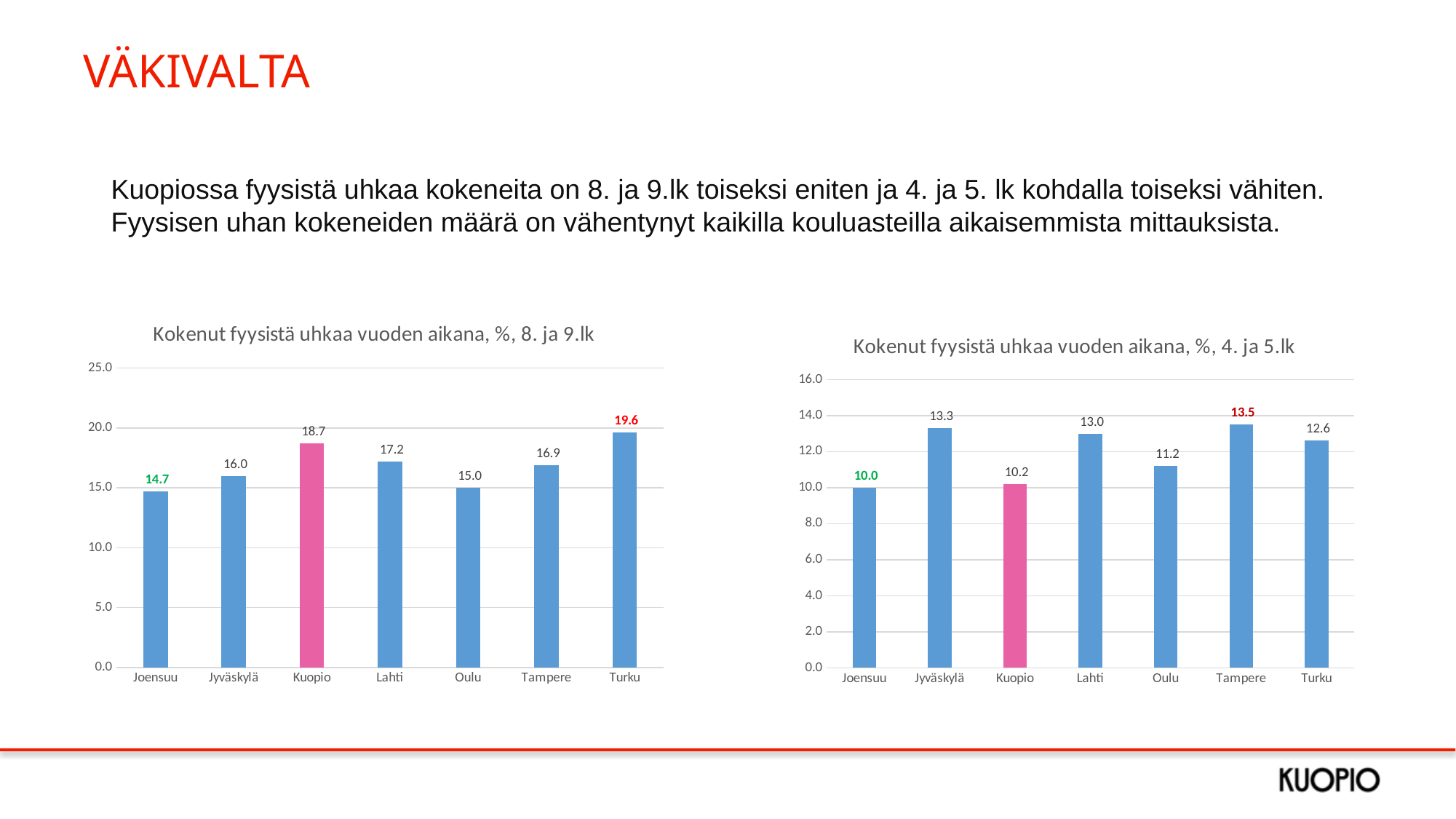
How many cities are shown in the chart 'Kokenut fyysistä uhkaa vuoden aikana, %, 8. ja 9.lk'? 7 In the chart 'Kokenut fyysistä uhkaa vuoden aikana, %, 8. ja 9.lk', what is the value for Kuopio? 18.7 In the chart 'Kokenut fyysistä uhkaa vuoden aikana, %, 8. ja 9.lk', what is the difference between Turku and Joensuu? 4.9 In the chart 'Kokenut fyysistä uhkaa vuoden aikana, %, 4. ja 5.lk', which city has the lowest value? Joensuu In the chart 'Kokenut fyysistä uhkaa vuoden aikana, %, 8. ja 9.lk', which is larger, Lahti or Tampere? Lahti In the chart 'Kokenut fyysistä uhkaa vuoden aikana, %, 8. ja 9.lk', which city has the highest value? Turku In the chart 'Kokenut fyysistä uhkaa vuoden aikana, %, 4. ja 5.lk', which city has the highest value? Tampere In the chart 'Kokenut fyysistä uhkaa vuoden aikana, %, 4. ja 5.lk', is the value for Turku greater or less than 12.0? greater In the chart 'Kokenut fyysistä uhkaa vuoden aikana, %, 4. ja 5.lk', what is the difference between Jyväskylä and Kuopio? 3.1 In the chart 'Kokenut fyysistä uhkaa vuoden aikana, %, 4. ja 5.lk', what is the value for Oulu? 11.2 What kind of chart is 'Kokenut fyysistä uhkaa vuoden aikana, %, 4. ja 5.lk'? Bar chart In the chart 'Kokenut fyysistä uhkaa vuoden aikana, %, 8. ja 9.lk', which city has the lowest value? Joensuu